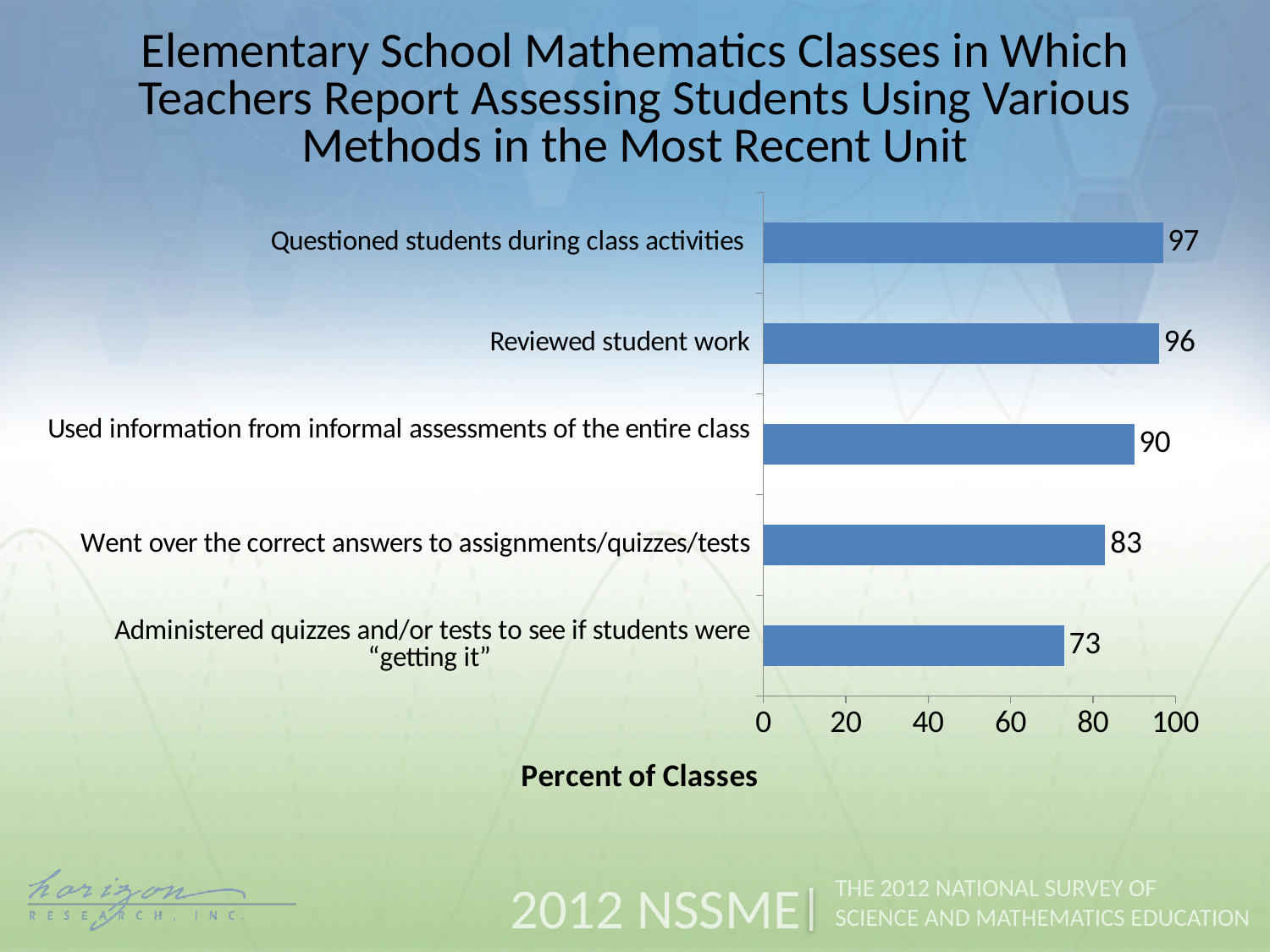
Which assessment method has the highest percent of classes? Questioned students during class activities What percent of classes used information from informal assessments of the entire class? 90 What kind of chart is shown on the slide? Bar chart What percent of classes reported that teachers questioned students during class activities? 97 What is the value for "Administered quizzes and/or tests to see if students were 'getting it'"? 73 Which is larger: the value for "Used information from informal assessments of the entire class" or the value for "Went over the correct answers to assignments/quizzes/tests"? Used information from informal assessments of the entire class What is the label of the horizontal axis? Percent of Classes Which assessment method has the lowest percent of classes? Administered quizzes and/or tests to see if students were "getting it" Is the value for "Went over the correct answers to assignments/quizzes/tests" greater or less than 80? greater What is the difference between the values for "Went over the correct answers to assignments/quizzes/tests" and "Administered quizzes and/or tests to see if students were 'getting it'"? 10 What is the value for "Reviewed student work"? 96 How many assessment methods are shown in the chart? 5